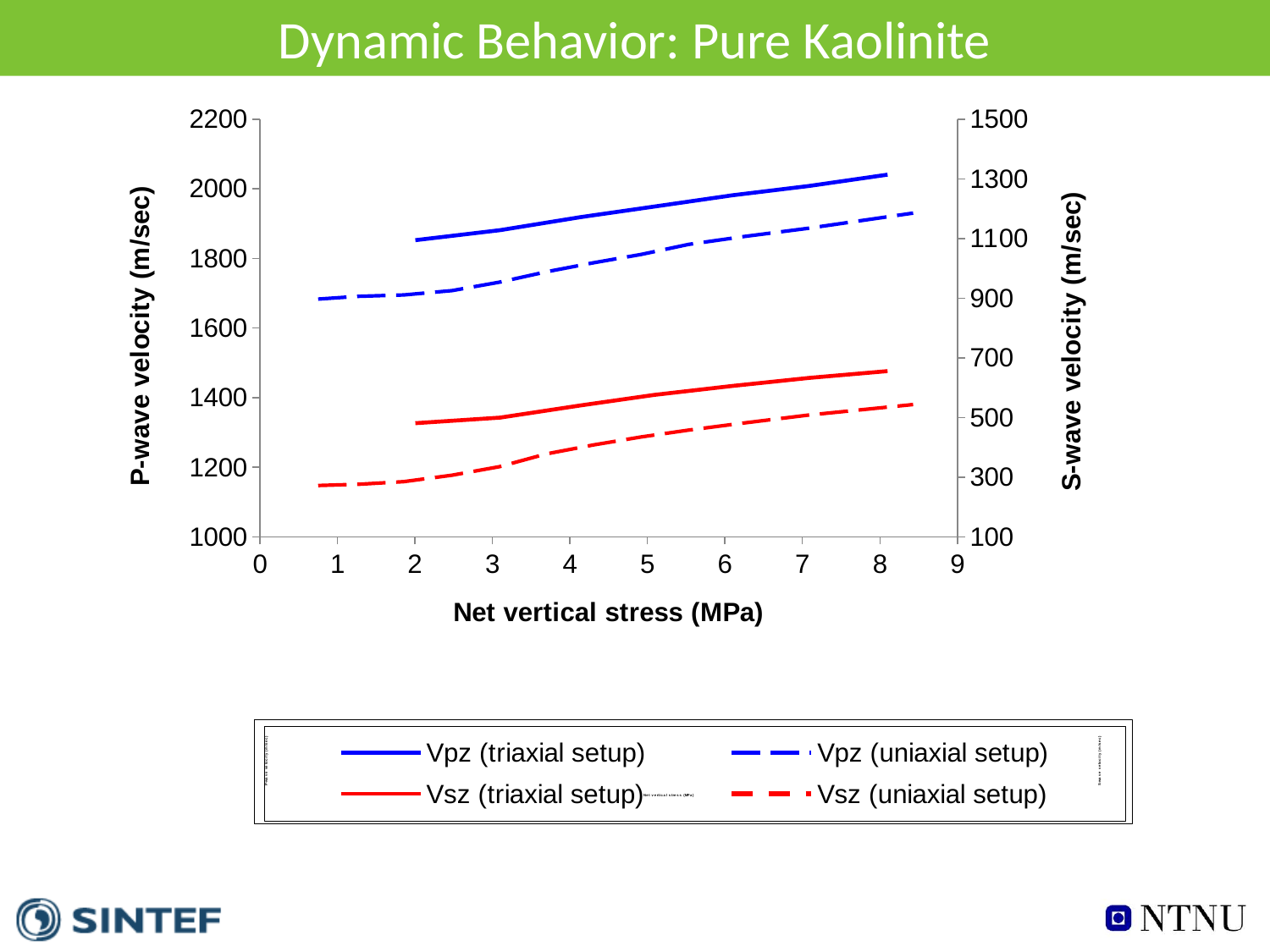
What is the title of the x axis? Net vertical stress (MPa) Does the Vsz (uniaxial setup) line rise or fall as net vertical stress increases? rise Does the Vpz (triaxial setup) line rise or fall as net vertical stress increases? rise Is the Vpz (triaxial setup) value at 2 MPa greater or less than 1900 on the P-wave axis? less Is the Vsz (uniaxial setup) value at 1 MPa greater or less than 500 on the S-wave axis? less How many series does the legend list? 4 What is the title of the right-hand y axis? S-wave velocity (m/sec) At 5 MPa, which is higher: Vpz (triaxial setup) or Vpz (uniaxial setup)? Vpz (triaxial setup) What kind of chart is shown on the slide? line chart Which series has the highest values on the chart? Vpz (triaxial setup) Is the Vpz (uniaxial setup) value at 1 MPa greater or less than 1800 on the P-wave axis? less At 4 MPa, which is higher: Vsz (triaxial setup) or Vsz (uniaxial setup)? Vsz (triaxial setup)